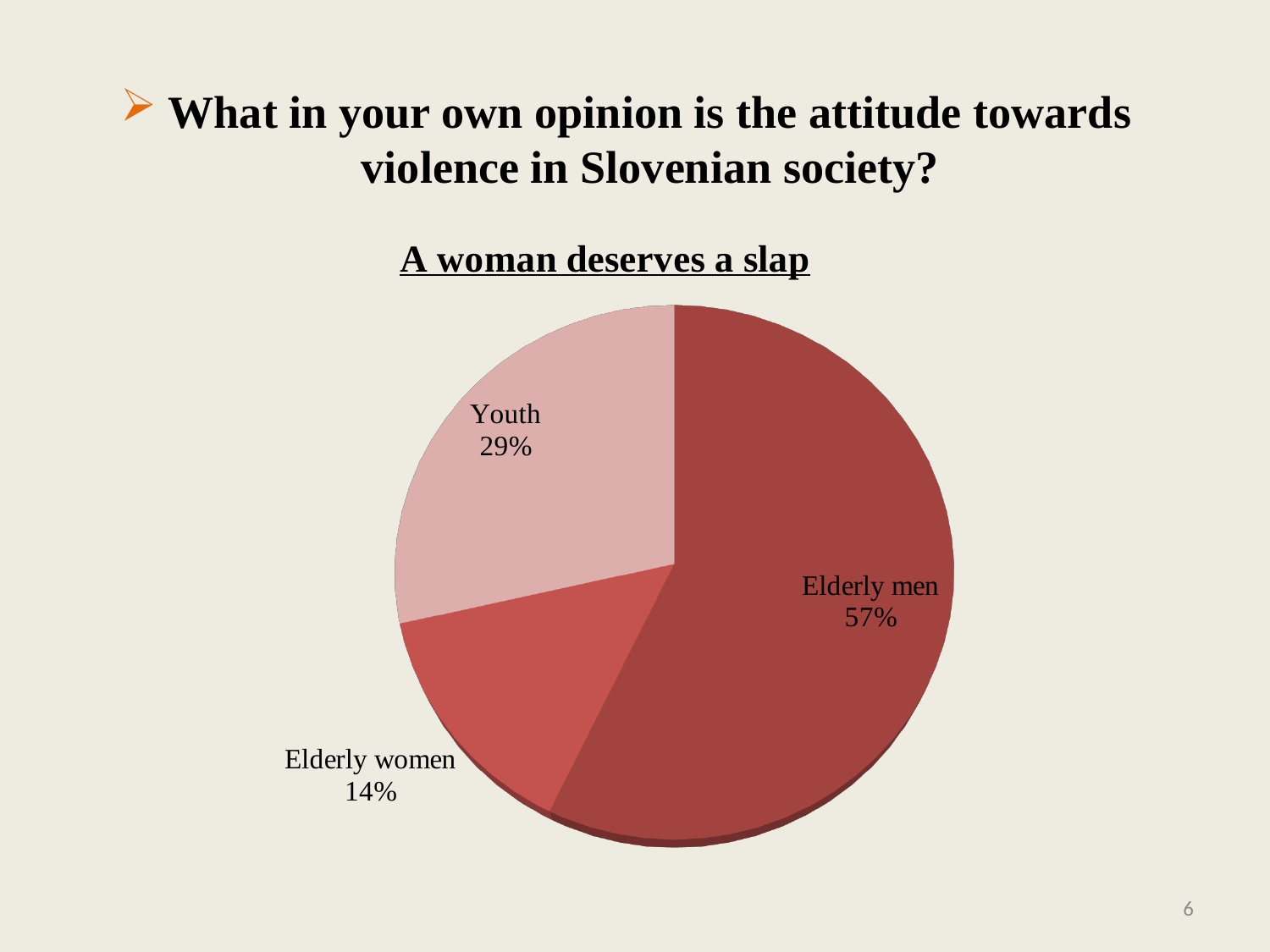
Which category has the smallest share of the pie? Elderly women What is the title of the pie chart? A woman deserves a slap What is the value for Elderly men? 57% What is the value for Elderly women? 14% Which is larger, the share for Youth or the share for Elderly women? Youth What is the difference between the Elderly men and Youth shares? 28% Which category is shown in the lightest pink colour? Youth What is the value for Youth? 29% Which category has the largest share of the pie? Elderly men How many categories are shown in the pie chart? 3 What kind of chart is shown on the slide? Pie chart What is the difference between the Youth and Elderly women shares? 15%